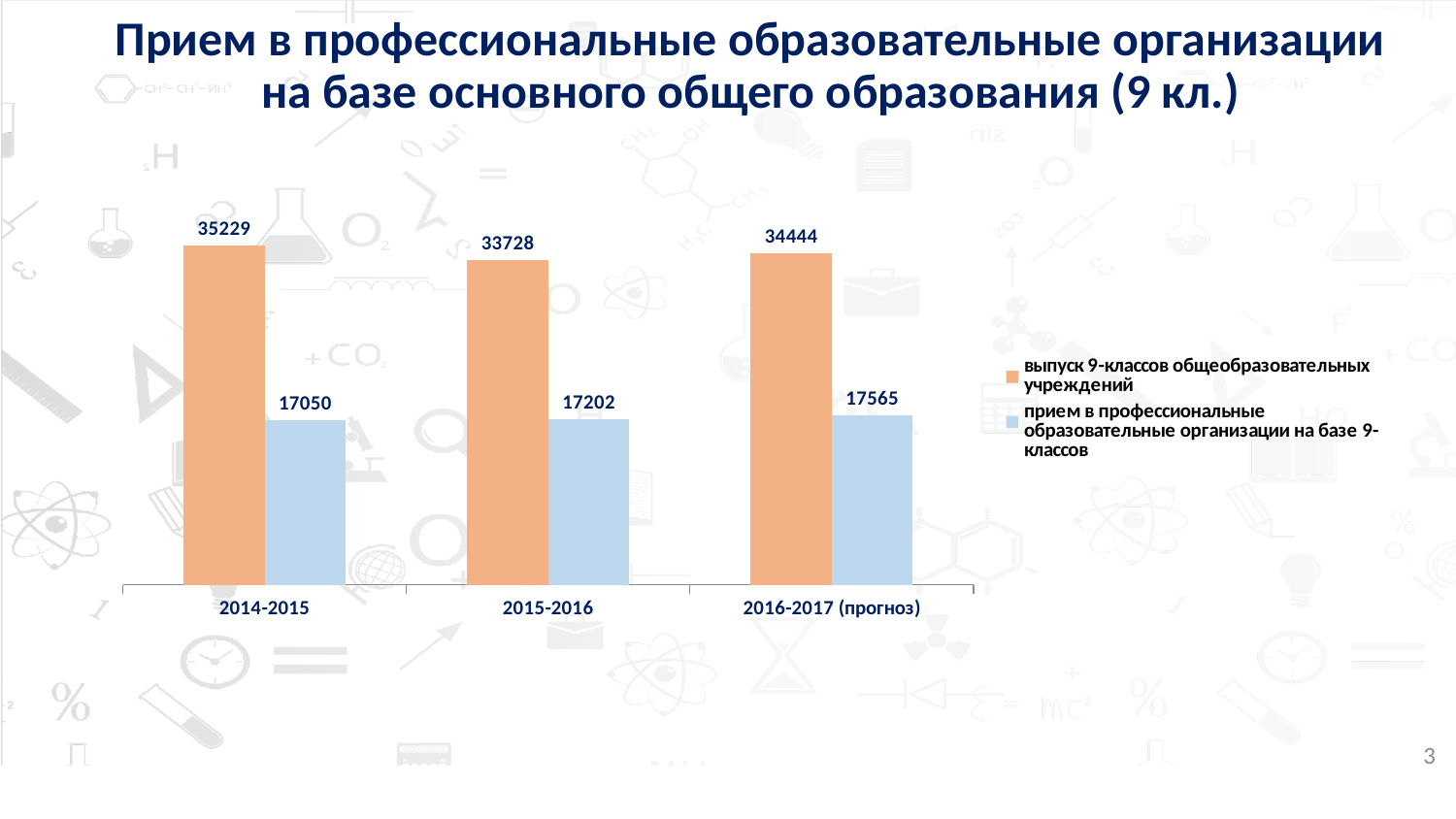
What is the value for выпуск 9-классов общеобразовательных учреждений in 2014-2015? 35229 In which period is the value for прием в профессиональные образовательные организации на базе 9-классов the highest? 2016-2017 (прогноз) What is the difference between выпуск 9-классов and прием в профессиональные образовательные организации in 2014-2015? 18179 What is the value for прием в профессиональные образовательные организации на базе 9-классов in 2016-2017 (прогноз)? 17565 What kind of chart is shown on the slide? bar chart Which is larger in 2016-2017 (прогноз): выпуск 9-классов общеобразовательных учреждений or прием в профессиональные образовательные организации? выпуск 9-классов общеобразовательных учреждений What is the value for прием в профессиональные образовательные организации на базе 9-классов in 2015-2016? 17202 How many series does the legend list? 2 In which period is the value for выпуск 9-классов общеобразовательных учреждений the lowest? 2015-2016 What is the difference between the выпуск 9-классов values for 2014-2015 and 2015-2016? 1501 Does the value for прием в профессиональные образовательные организации на базе 9-классов rise or fall from 2014-2015 to 2016-2017 (прогноз)? rise How many periods are shown on the x axis? 3